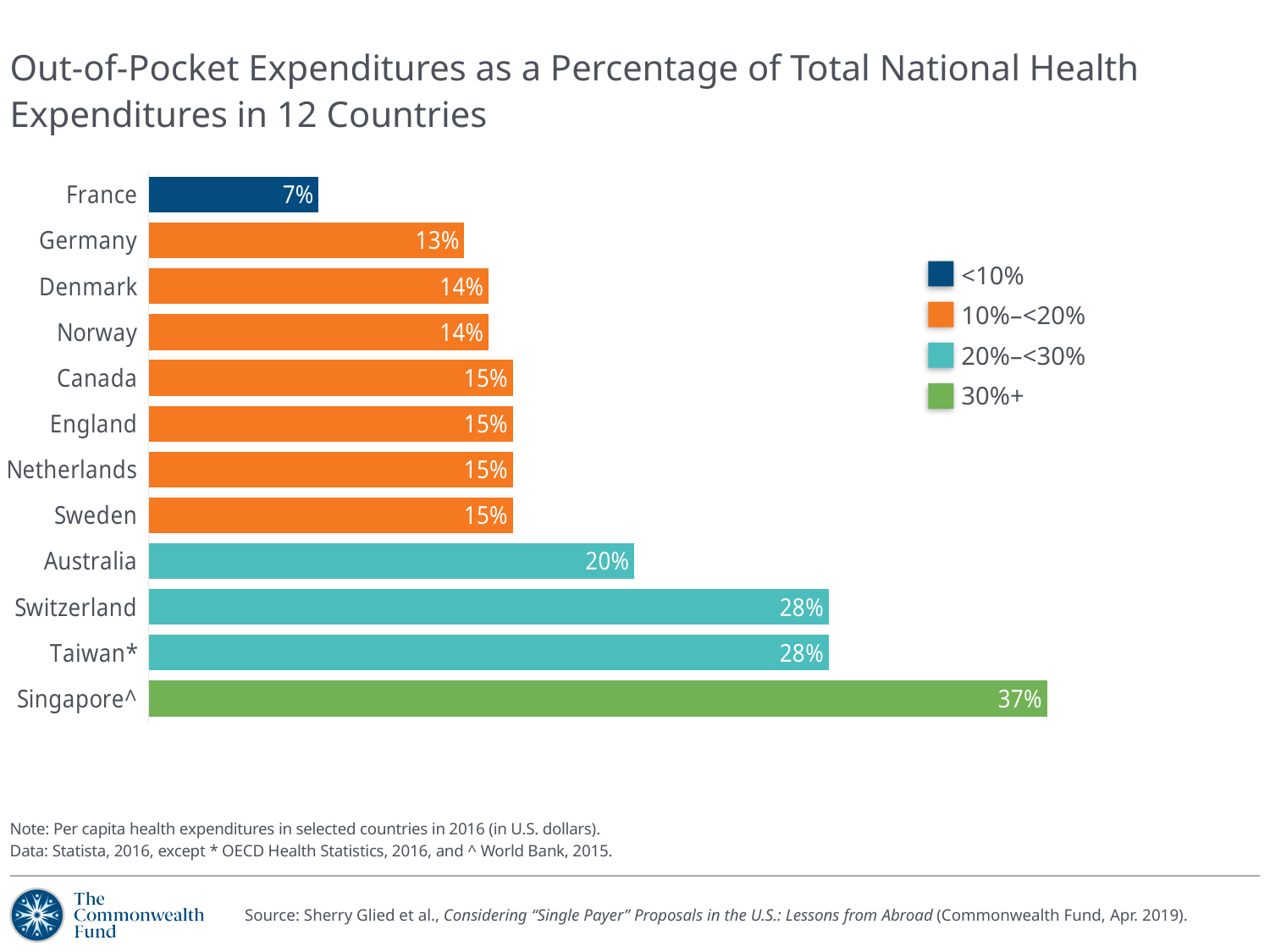
What is the out-of-pocket expenditure percentage for France? 7% How many entries does the legend list? 4 What is the difference between the values for Switzerland and Australia? 8% Which country has the highest out-of-pocket expenditure percentage? Singapore^ Which country has the lowest out-of-pocket expenditure percentage? France What is the value shown for Germany? 13% Which legend category does the bar for Singapore^ belong to? 30%+ What kind of chart is shown on the slide? Bar chart What is the difference between the values for Singapore^ and France? 30% What is the value shown for Australia? 20% How many countries are shown in the chart? 12 Which is larger, the value for Canada or the value for Germany? Canada